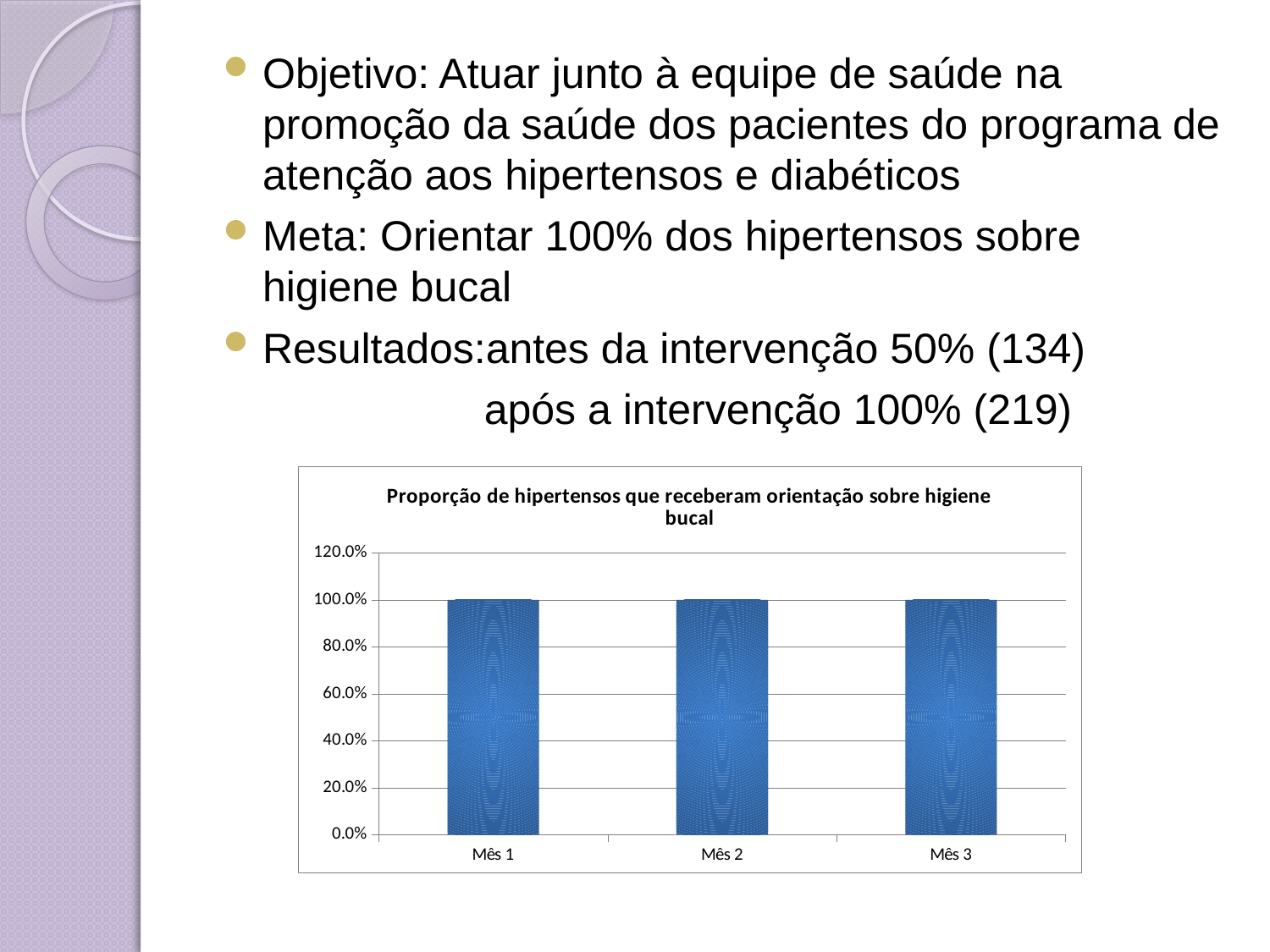
Do the values rise, fall or stay the same from Mês 1 to Mês 3? stay the same What kind of chart is shown on the slide? bar chart What is the title of the chart? Proporção de hipertensos que receberam orientação sobre higiene bucal Is the value for Mês 1 greater or less than 80.0%? greater What is the value for Mês 1 in the chart? 100.0% What is the value for Mês 3 in the chart? 100.0% Is the value for Mês 3 greater or less than 120.0%? less How many categories are shown on the x axis of the chart? 3 What is the value for Mês 2 in the chart? 100.0% What is the highest value shown on the y axis of the chart? 120.0% What is the difference between the values for Mês 1 and Mês 2? 0.0%